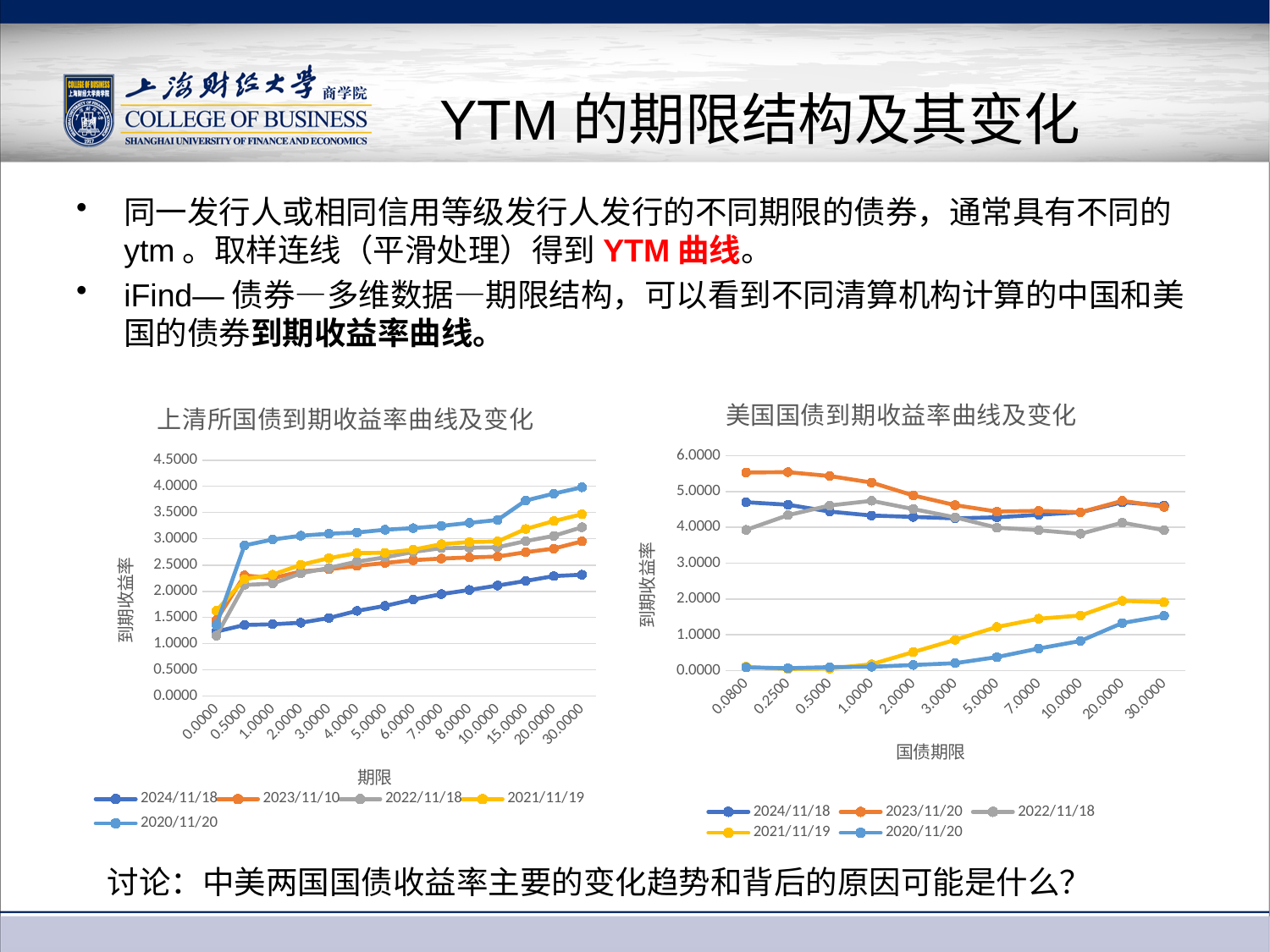
In the left chart (上清所国债到期收益率曲线及变化), is the value of the 2020/11/20 series at 30.0000 greater or less than 3.5000? greater In the left chart (上清所国债到期收益率曲线及变化), how many series does the legend list? 5 In the left chart (上清所国债到期收益率曲线及变化), which series has the highest value at 30.0000? 2020/11/20 In the right chart (美国国债到期收益率曲线及变化), does the 2023/11/20 series overall rise or fall as 国债期限 increases along the x axis? Fall In the right chart (美国国债到期收益率曲线及变化), how many series does the legend list? 5 In the left chart (上清所国债到期收益率曲线及变化), how many 期限 categories are shown on the x axis? 14 In the right chart (美国国债到期收益率曲线及变化), which series has the lowest value at 30.0000? 2020/11/20 In the left chart (上清所国债到期收益率曲线及变化), does the 2024/11/18 series rise or fall as 期限 increases along the x axis? Rise In the right chart (美国国债到期收益率曲线及变化), how many 国债期限 categories are shown on the x axis? 11 In the right chart (美国国债到期收益率曲线及变化), at 1.0000, which series has the larger value: 2023/11/20 or 2024/11/18? 2023/11/20 What kind of chart is the left chart titled 上清所国债到期收益率曲线及变化? Line chart In the right chart (美国国债到期收益率曲线及变化), is the value of the 2020/11/20 series at 0.0800 greater or less than 1.0000? less